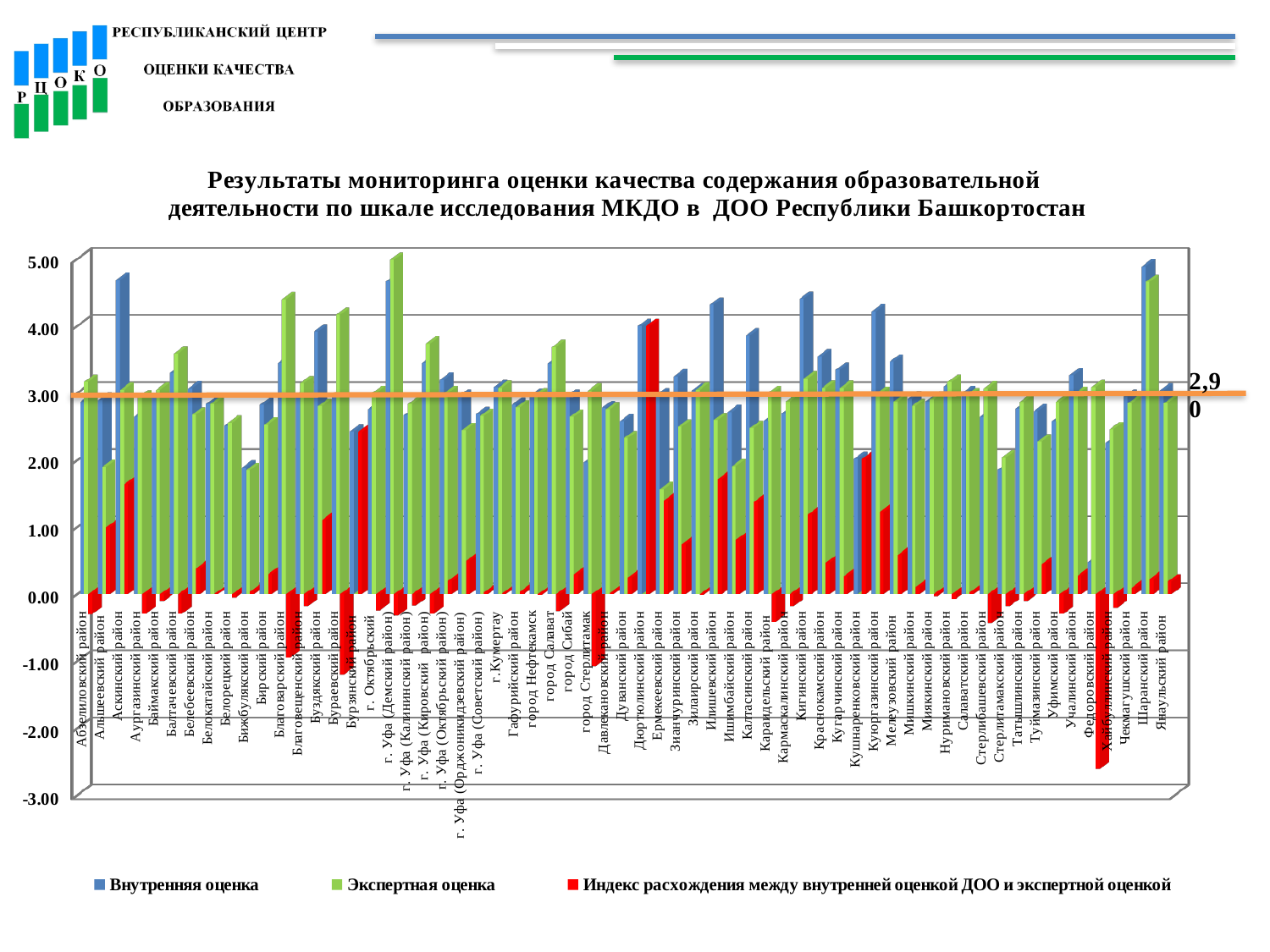
Is the Индекс расхождения value for Хайбуллинский район greater or less than -2.00? greater Is the Экспертная оценка value for Белорецкий район greater or less than 3.00? less For Дюртюлинский район, which is larger: the Внутренняя оценка or the Индекс расхождения? They are equal (both 4.00) Which category has the highest value for Экспертная оценка? г. Уфа (Демский район) How many series does the legend list? 3 Which series is shown in green according to the legend? Экспертная оценка Is the Индекс расхождения value for Ермекеевский район greater or less than 3.00? less Which series is shown in red according to the legend? Индекс расхождения между внутренней оценкой ДОО и экспертной оценкой What kind of chart is shown on the slide? bar chart Which category has the lowest value for Индекс расхождения между внутренней оценкой ДОО и экспертной оценкой? Федоровский район